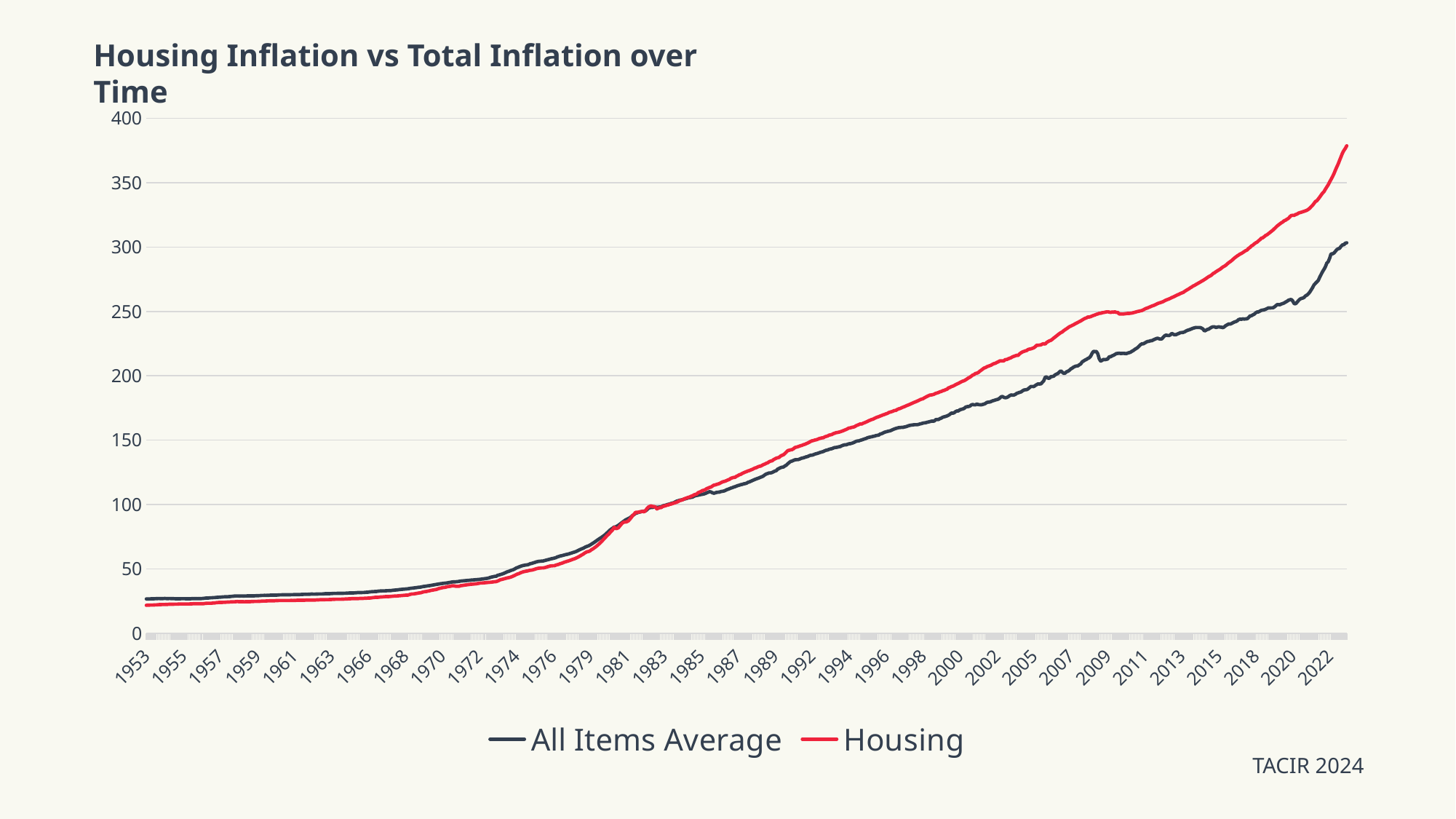
Do the values for All Items Average rise or fall over the period shown? rise Is the value for Housing at the end of the series (2022) greater or less than 350? greater What is the title of the chart? Housing Inflation vs Total Inflation over Time Is the value for Housing in 1953 greater or less than 50? less Which series is drawn in red? Housing What kind of chart is shown on the slide? line chart How many series does the legend list? 2 In 1961, which series has the higher value, Housing or All Items Average? All Items Average Is the value for All Items Average in 1981 greater or less than 100? less At the end of the series (2022), which series has the higher value, Housing or All Items Average? Housing Do the values for Housing rise or fall from 1953 to 2022? rise